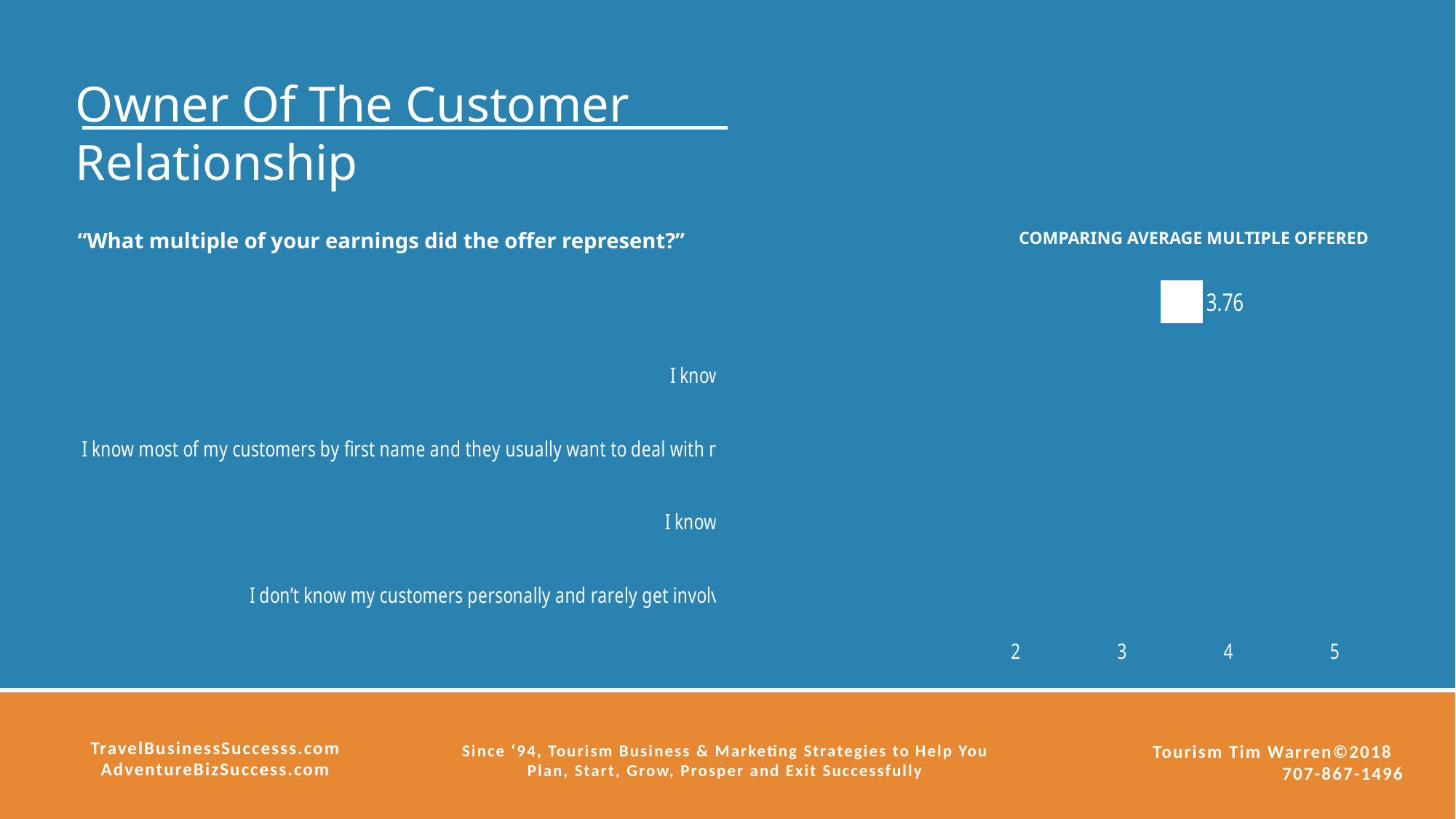
In the chart titled "COMPARING AVERAGE MULTIPLE OFFERED", is the plotted value labelled 3.76 greater or less than 4? less In the chart titled "COMPARING AVERAGE MULTIPLE OFFERED", is the plotted value labelled 3.76 greater or less than 2? greater What is the title of the chart on the right side of the slide? COMPARING AVERAGE MULTIPLE OFFERED In the chart titled "COMPARING AVERAGE MULTIPLE OFFERED", what is the only data value printed on the chart? 3.76 In the chart titled "COMPARING AVERAGE MULTIPLE OFFERED", what is the highest tick label shown on the horizontal axis? 5 In the chart titled "COMPARING AVERAGE MULTIPLE OFFERED", is the plotted value labelled 3.76 greater or less than 3? greater